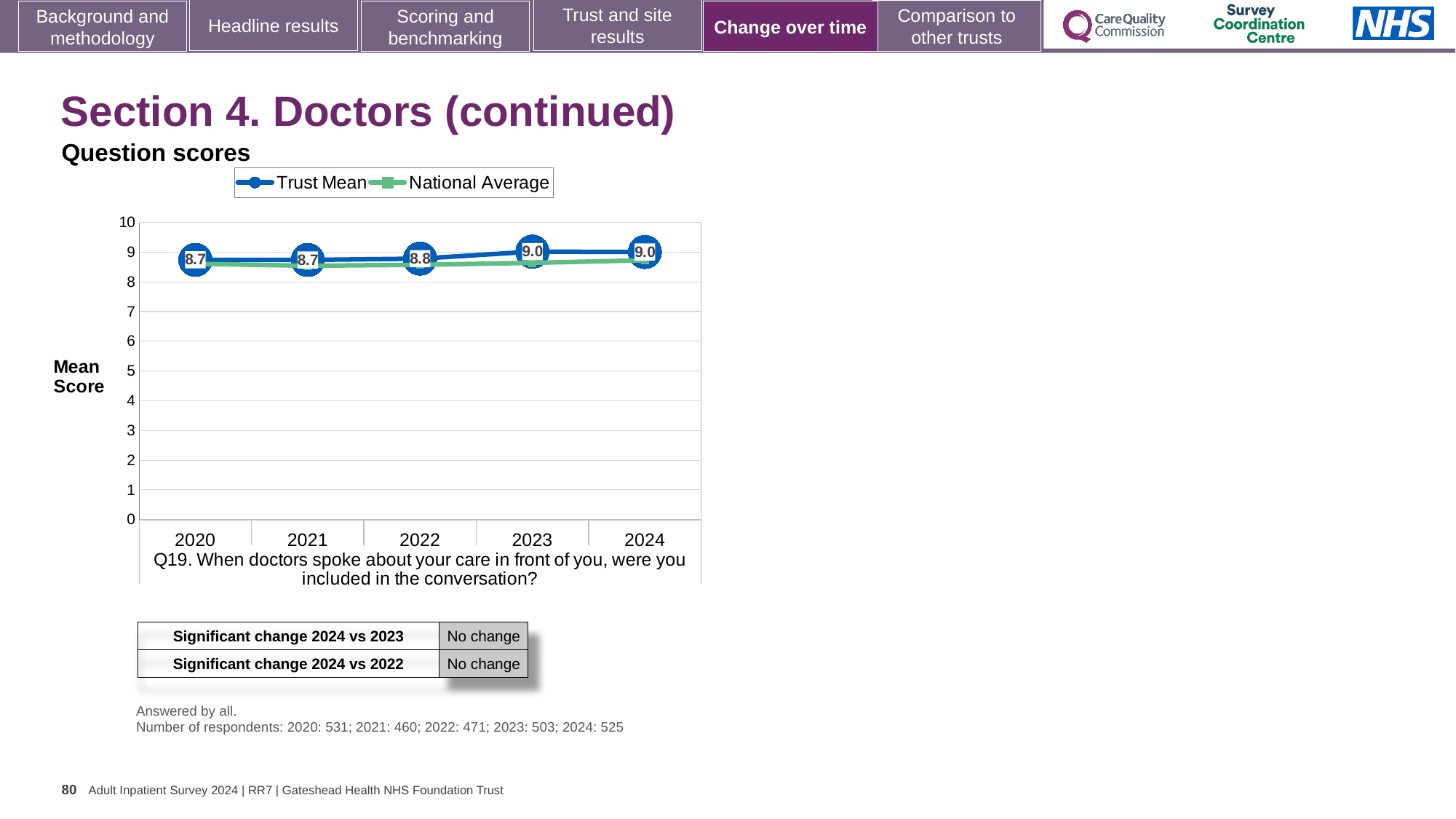
How many years are shown on the x axis of the chart? 5 How many series does the chart legend list? 2 What kind of chart is shown on the slide? Line chart What is the Trust Mean score for 2023? 9.0 What is the difference between the Trust Mean score in 2024 and in 2020? 0.3 Does the Trust Mean score rise or fall from 2020 to 2024? Rise What is the Trust Mean score for 2022? 8.8 Is the National Average value for 2020 greater or less than 8? greater What are the two series named in the chart legend? Trust Mean and National Average Which is larger, the Trust Mean score for 2023 or for 2021? 2023 What is the Trust Mean score for 2020? 8.7 What is the Trust Mean score for 2024? 9.0